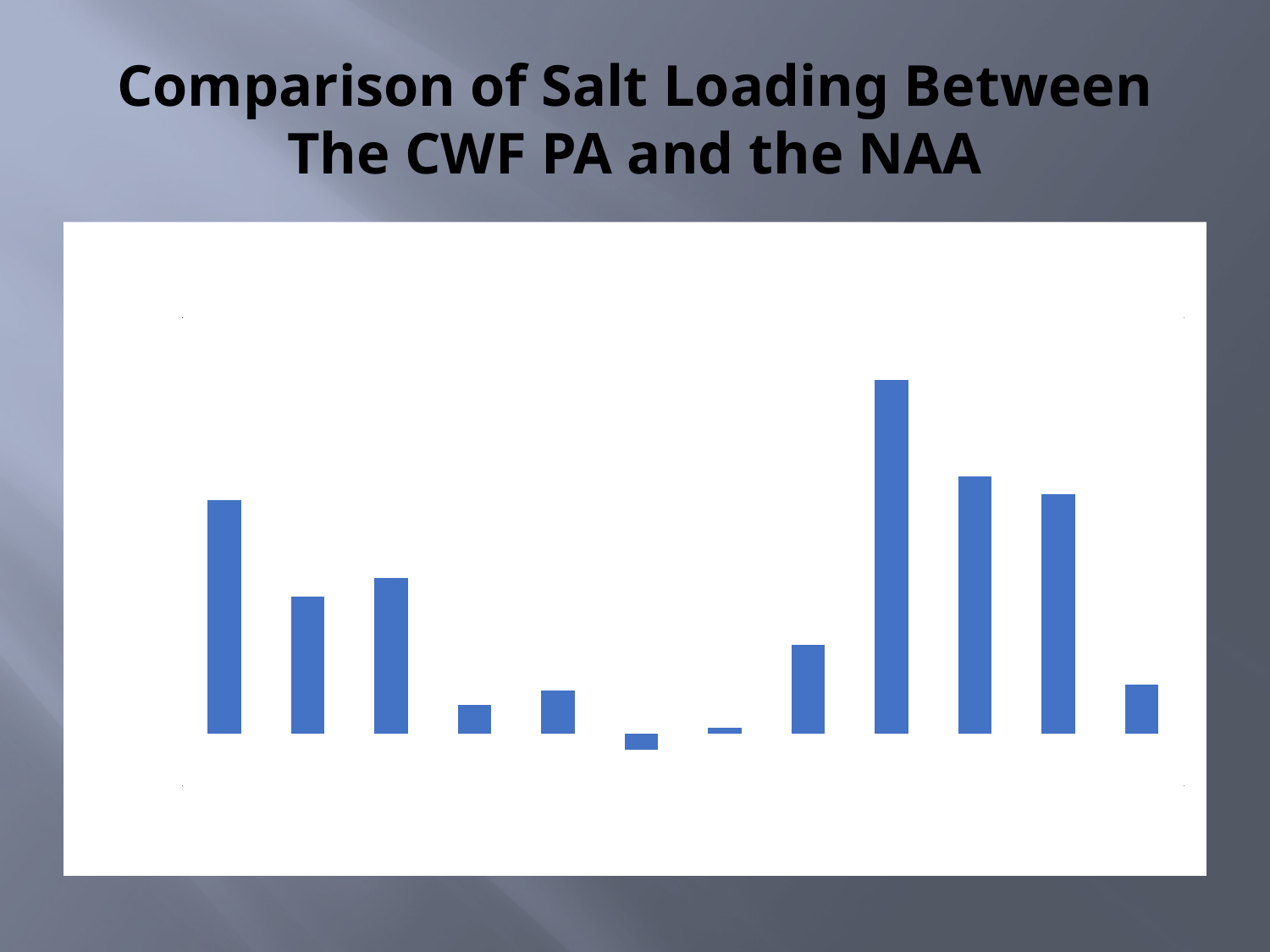
Is the tenth bar from the left taller or shorter than the eleventh bar from the left? taller How many bars extend below the baseline in the chart? 1 What kind of chart is shown on the slide? bar chart Is the first bar from the left taller or shorter than the second bar from the left? taller What colour are the bars in the chart? blue Counting from the left, which bar extends furthest below the baseline? the sixth bar Counting from the left, which bar is the tallest in the chart? the ninth bar How many bars are plotted in the chart? 12 What is the title of the slide containing the chart? Comparison of Salt Loading Between The CWF PA and the NAA